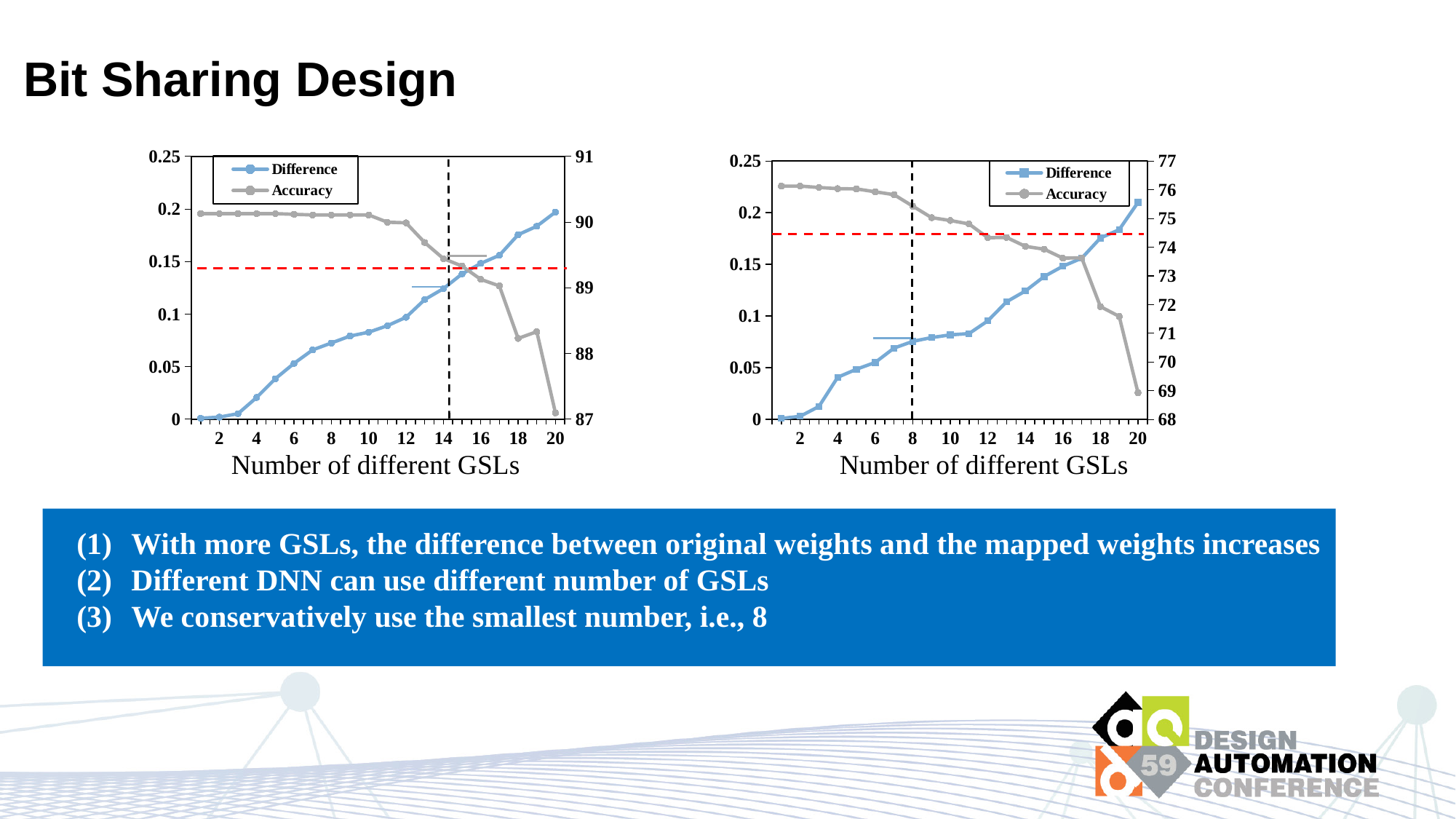
In the right chart, is the Accuracy value at 2 GSLs greater or less than 75? greater In the left chart, does the Difference series rise or fall as the number of different GSLs increases? rises What kind of chart is the left chart on the slide? line chart In the right chart, is the Accuracy value at 20 GSLs greater or less than 70? less In the left chart, is the Difference value at 4 GSLs greater or less than 0.05? less What is the x-axis label of the right chart? Number of different GSLs How many series does the legend of the right chart list? 2 In the left chart, which series is drawn in grey? Accuracy In the right chart, does the Accuracy series rise or fall as the number of different GSLs increases? falls